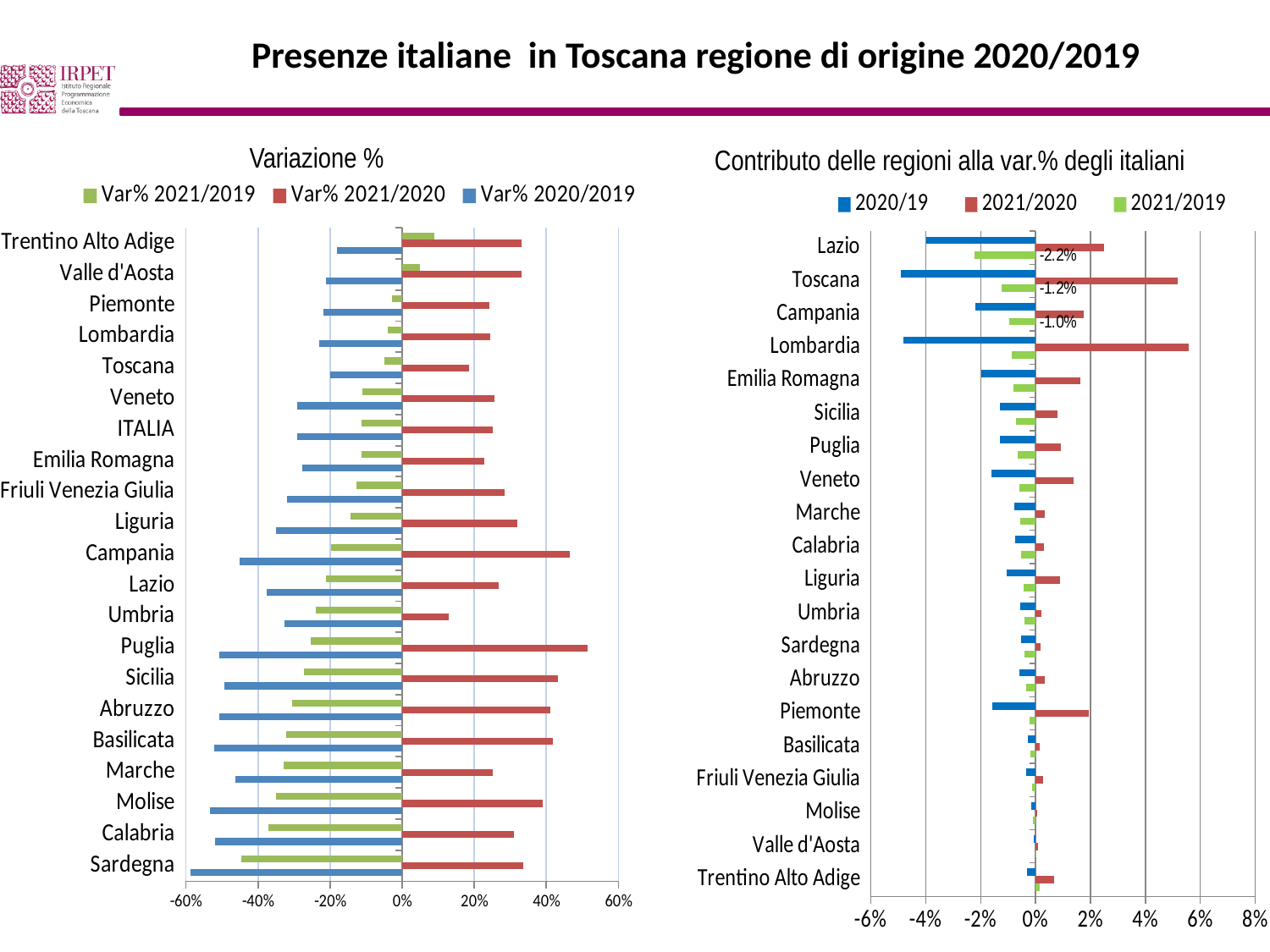
In the 'Contributo delle regioni alla var.% degli italiani' chart, what is the 2021/2019 value for Lazio? -2.2% In the 'Variazione %' chart, is the Var% 2021/2020 value for Campania greater or less than 40%? greater In the 'Variazione %' chart, which has the larger Var% 2021/2019 value, Trentino Alto Adige or Sardegna? Trentino Alto Adige In the 'Contributo delle regioni alla var.% degli italiani' chart, what is the 2021/2019 value for Toscana? -1.2% In the 'Contributo delle regioni alla var.% degli italiani' chart, what is the difference between the 2021/2019 values for Lazio and Toscana? 1.0% In the 'Contributo delle regioni alla var.% degli italiani' chart, is the 2021/2020 value for Lombardia greater or less than 4%? greater In the 'Contributo delle regioni alla var.% degli italiani' chart, what is the 2021/2019 value for Campania? -1.0% How many categories are shown on the 'Variazione %' chart? 21 In the 'Variazione %' chart, which region has the highest Var% 2021/2020 value? Puglia In the 'Variazione %' chart, is the Var% 2020/2019 value for Sardegna greater or less than -40%? less What type of chart is the 'Variazione %' chart on the left? bar chart How many series does the legend of the 'Variazione %' chart list? 3